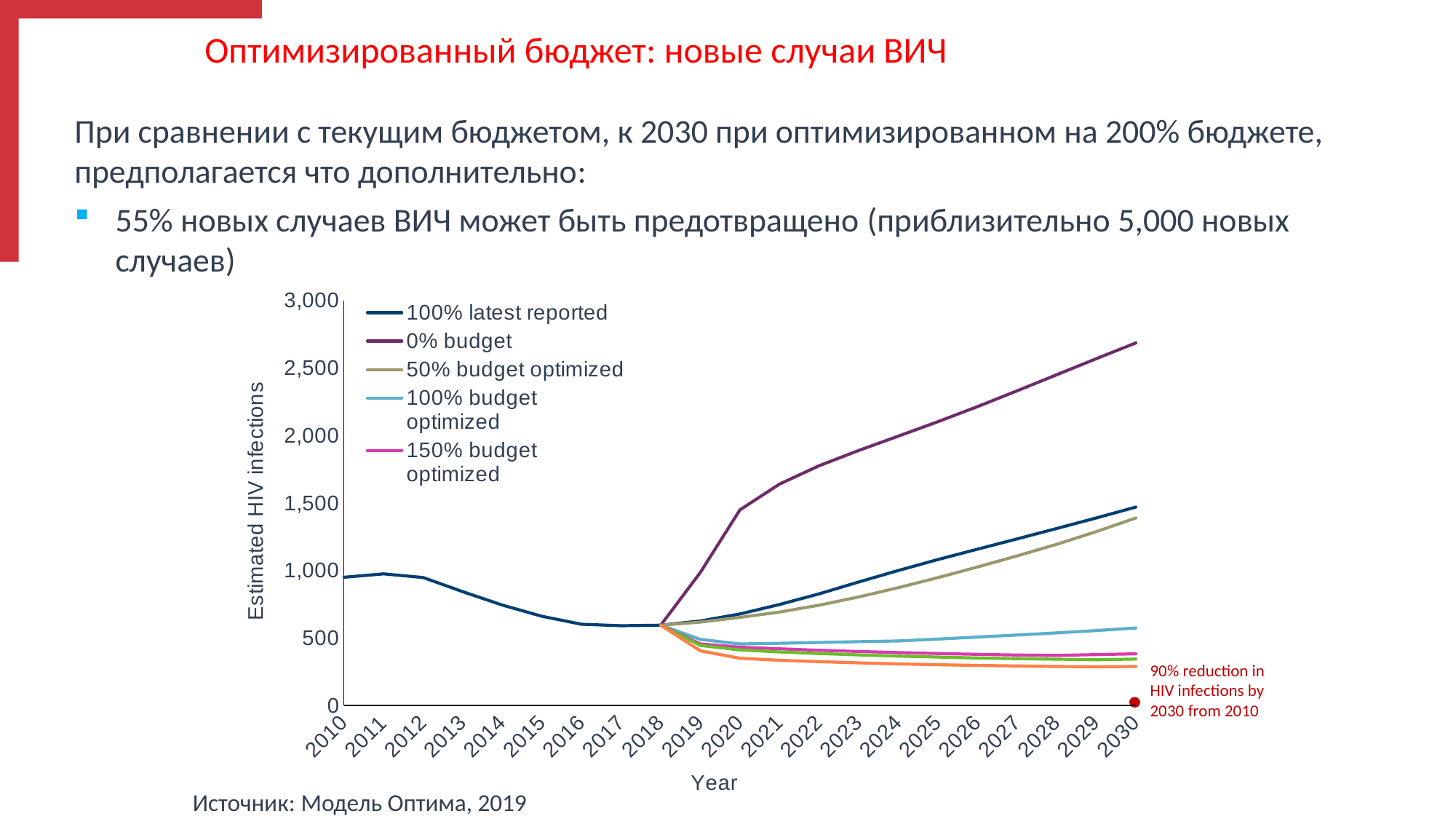
Is the value for the 0% budget series in 2030 greater or less than 2,500? greater In 2030, which is larger: the 0% budget series or the 100% latest reported series? 0% budget Is the value for the 100% budget optimized series in 2030 greater or less than 1,000? less How many series does the chart legend list? 5 How many years are shown on the x axis of the chart? 21 Is the value for the 100% latest reported series in 2010 greater or less than 500? greater Does the 0% budget series rise or fall from 2018 to 2030? rise What kind of chart is shown on the slide? line chart What is the label of the y axis of the chart? Estimated HIV infections In 2030, which is larger: the 50% budget optimized series or the 100% budget optimized series? 50% budget optimized Which series has the highest value in 2030? 0% budget